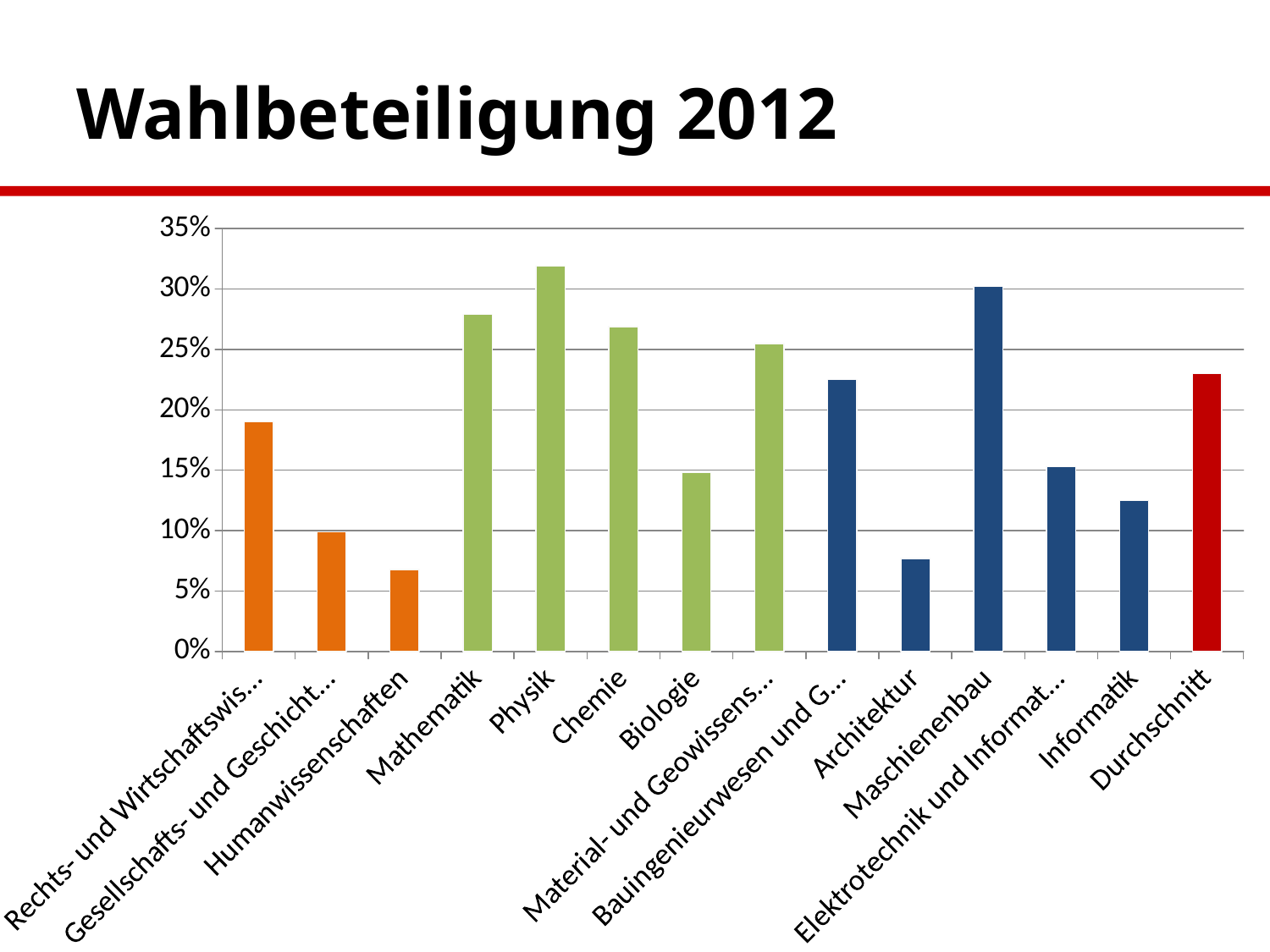
Which is larger, the value for Biologie or the value for Informatik? Biologie What colour is the Durchschnitt bar? red Which is larger, the value for Physik or the value for Maschinenbau? Physik Is the value for Architektur greater or less than 10%? less Is the value for Durchschnitt greater or less than 20%? greater What is the title of the slide? Wahlbeteiligung 2012 How many bars (categories) are plotted in the chart? 14 What kind of chart is shown on the slide? bar chart Which category has the highest value? Physik Is the value for Mathematik greater or less than 25%? greater